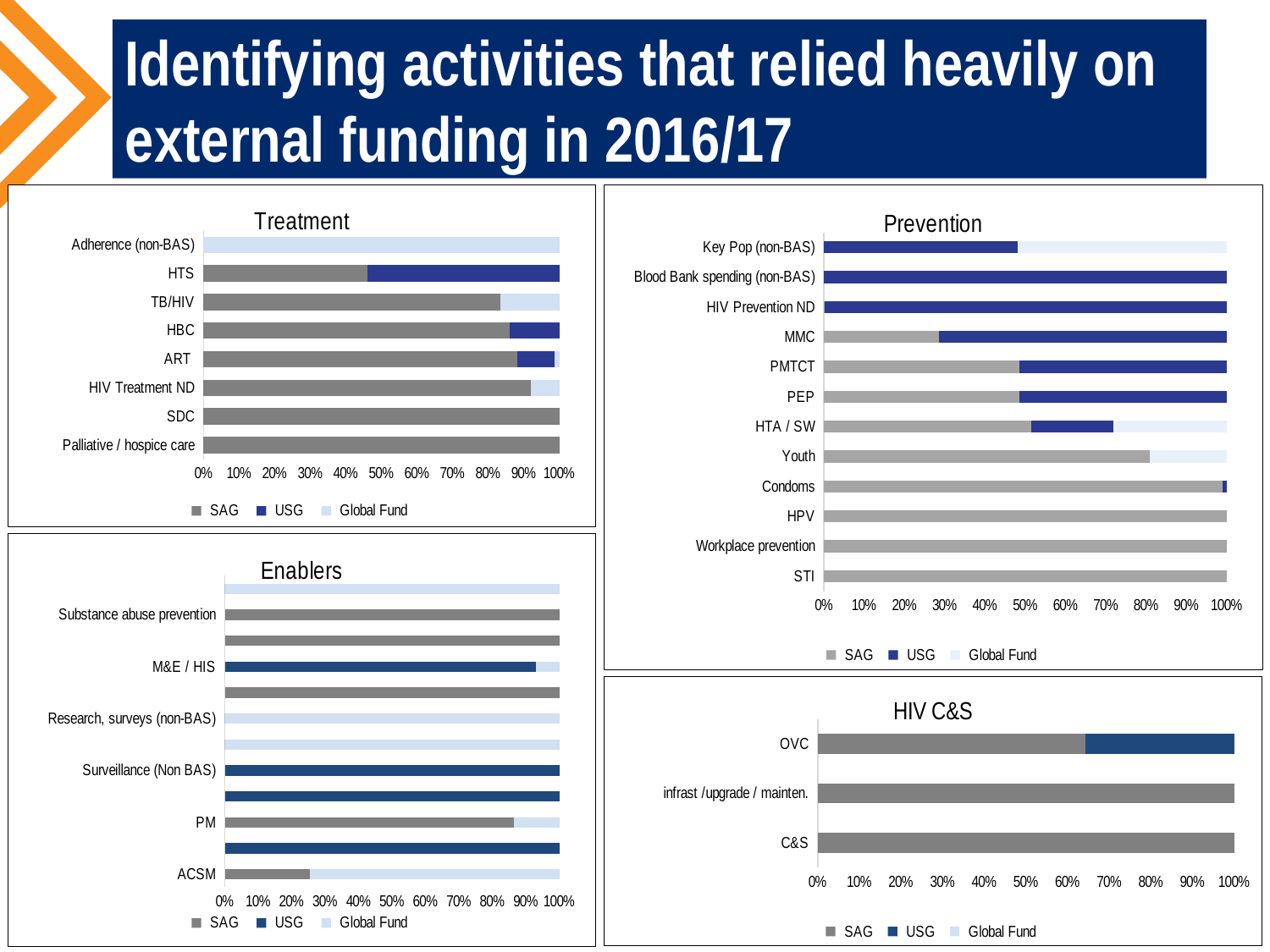
How many categories are shown in the Prevention chart? 12 What are the legend entries in the Enablers chart? SAG, USG, Global Fund In the Treatment chart, is the SAG share for TB/HIV greater or less than 70%? greater In the Enablers chart, is the SAG share for ACSM greater or less than 40%? less How many series does the legend of the Prevention chart list? 3 In the Prevention chart, which funder accounts for the entire bar for HIV Prevention ND? USG How many categories are shown in the HIV C&S chart? 3 In the HIV C&S chart, is the SAG share for OVC greater or less than 50%? greater What kind of chart is the Treatment chart? bar chart How many categories are shown in the Treatment chart? 8